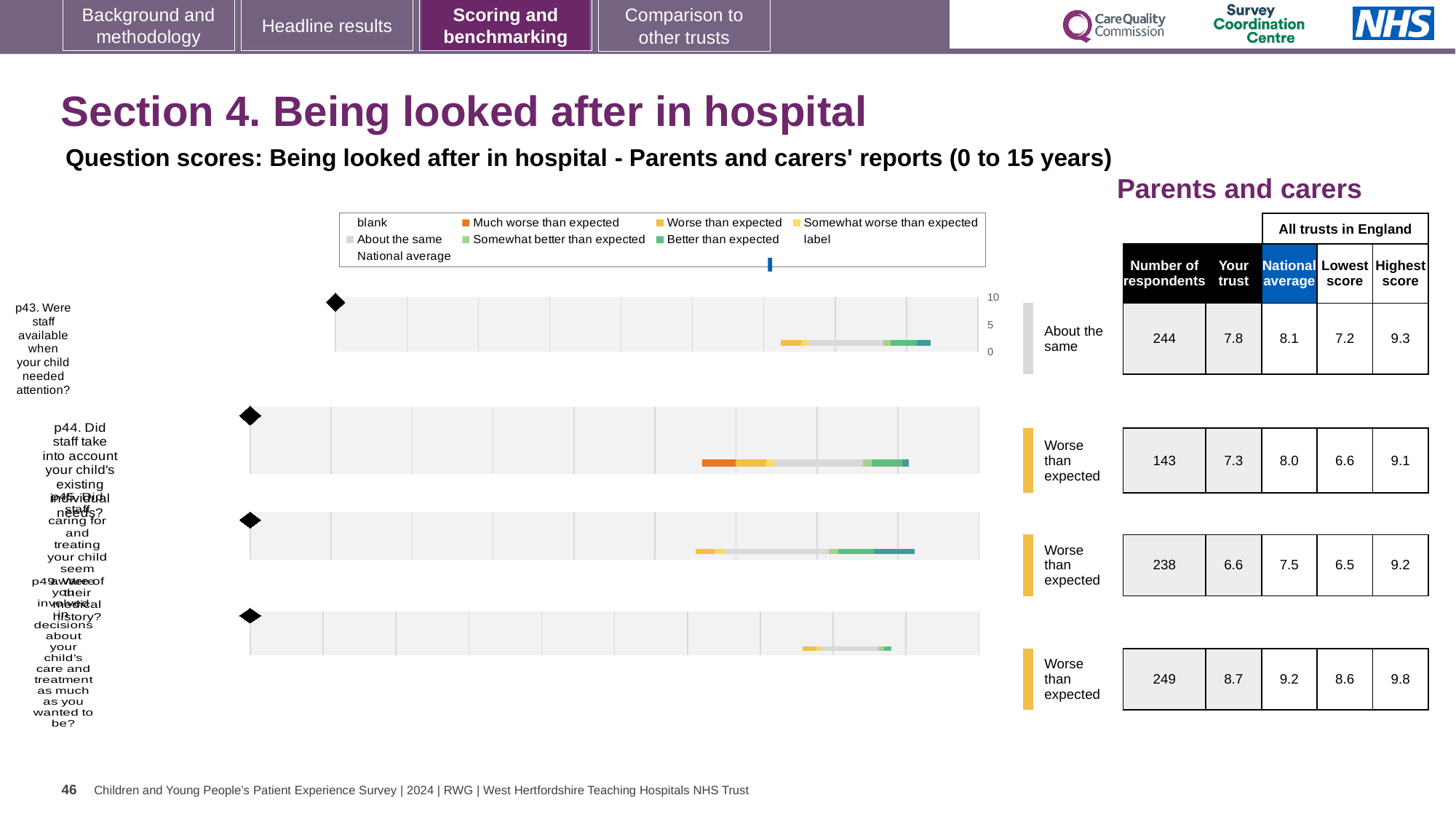
Which question has the lowest 'Your trust' score? p45 What is the highest score across all trusts in England for p49? 9.8 How many of the four questions are rated 'Worse than expected'? 3 How many respondents answered p45? 238 What is the difference between the national average and the 'Your trust' score for p45? 0.9 Which question has the highest 'Your trust' score? p49 What benchmark category is shown for p43? About the same What is the national average score for p44 (Did staff take into account your child's existing individual needs)? 8.0 How many questions (rows) are plotted in the chart? 4 What kind of chart is used to show the question scores on this slide? bar chart What is the 'Your trust' score for p43 (Were staff available when your child needed attention)? 7.8 For p43, which is larger: the 'Your trust' score or the national average? National average